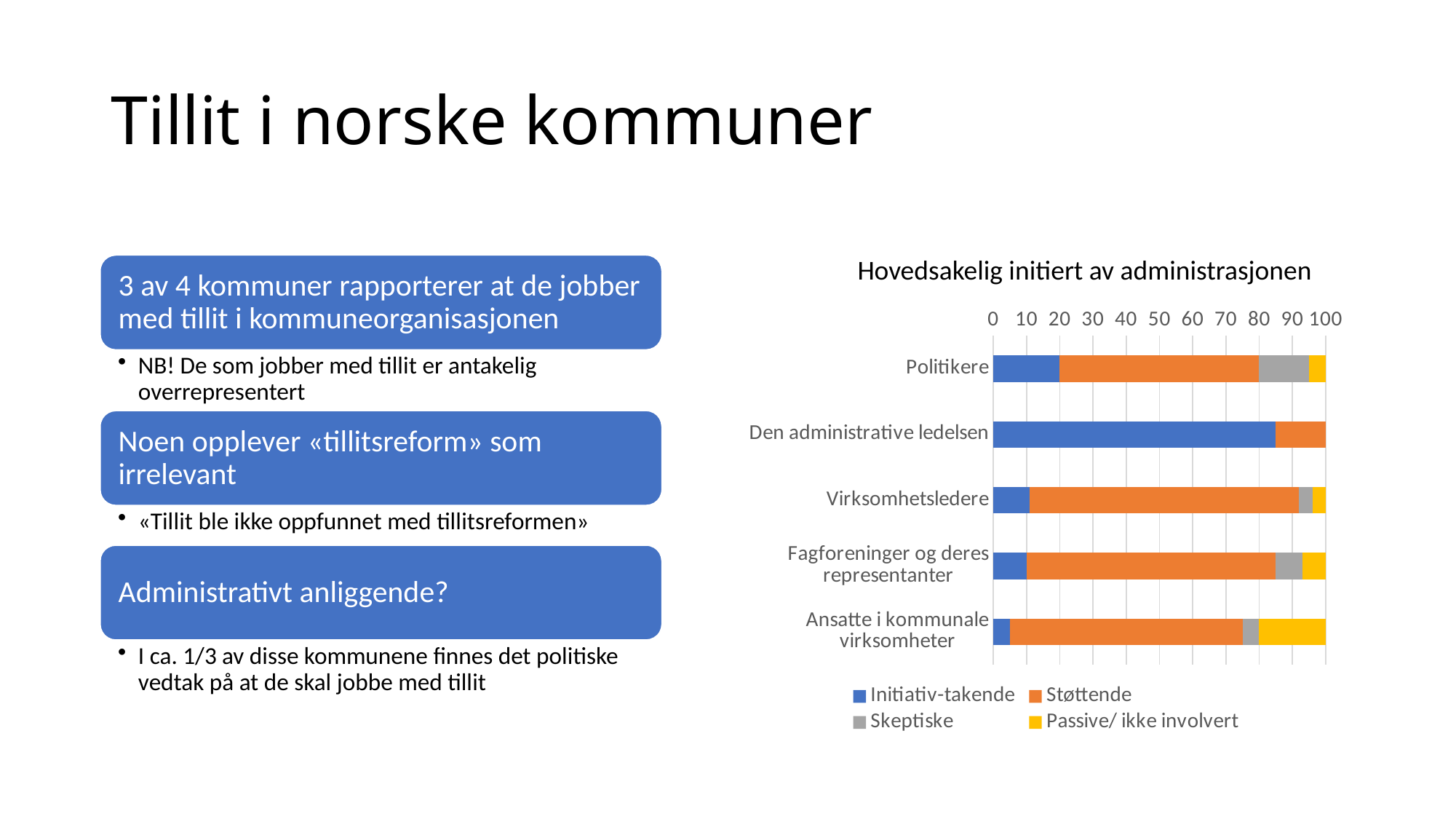
What is the title of the chart? Hovedsakelig initiert av administrasjonen Which category has the largest Initiativ-takende segment? Den administrative ledelsen Is the Initiativ-takende value for Politikere greater or less than 30? less Which category has the smallest Initiativ-takende segment? Ansatte i kommunale virksomheter Which has the larger Initiativ-takende segment, Politikere or Virksomhetsledere? Politikere What colour represents the Støttende series in the chart? Orange How many categories are shown on the chart's vertical axis? 5 Is the Initiativ-takende value for Den administrative ledelsen greater or less than 70? greater What kind of chart is shown on the slide? Stacked bar chart Which category has the largest Passive/ ikke involvert segment? Ansatte i kommunale virksomheter Is the Initiativ-takende value for Ansatte i kommunale virksomheter greater or less than 10? less How many series does the chart's legend list? 4